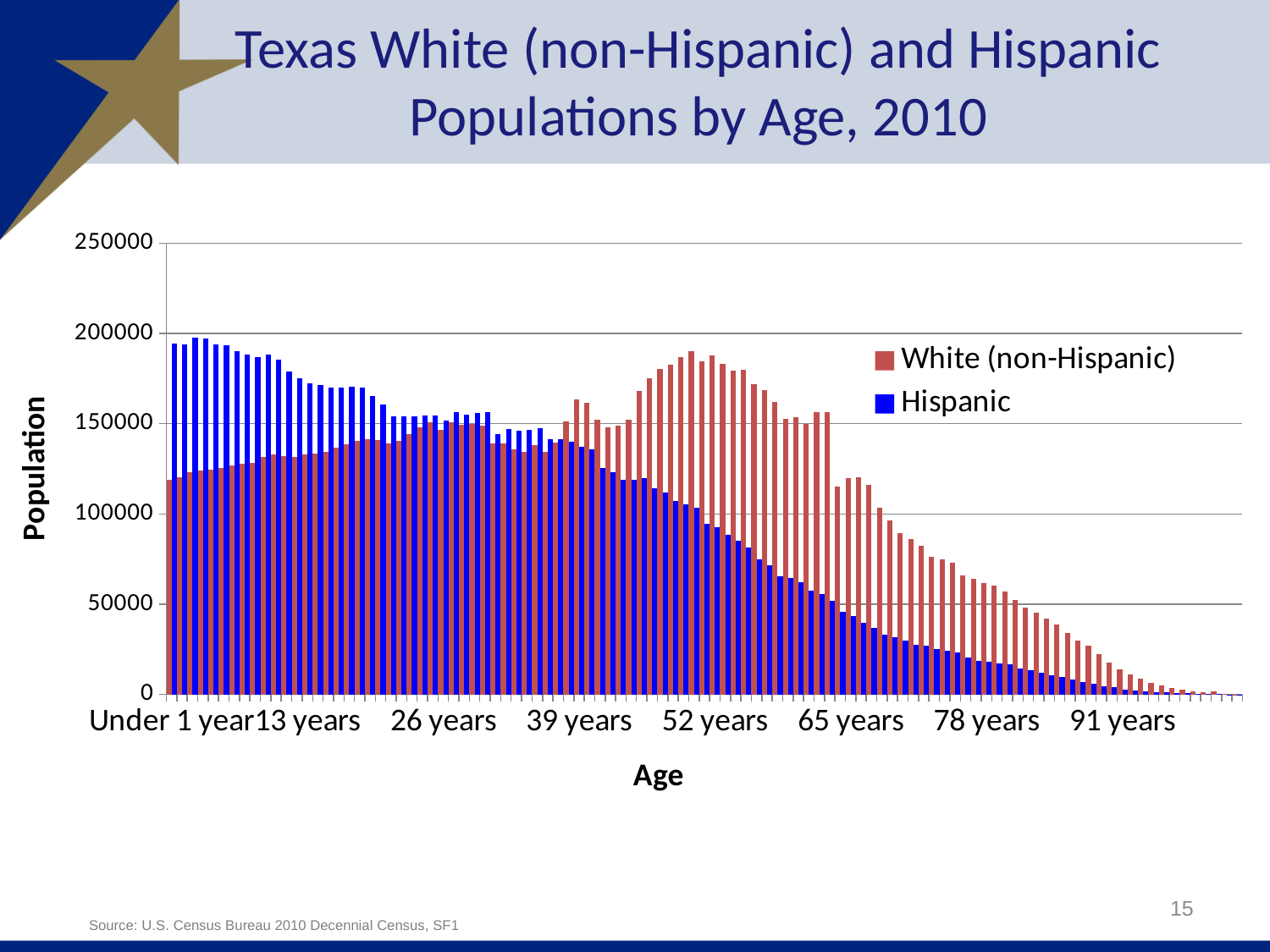
What kind of chart is shown on the slide? bar chart Do the Hispanic values generally rise or fall from 39 years to 91 years? fall Which series has the larger value at 52 years, White (non-Hispanic) or Hispanic? White (non-Hispanic) Is the White (non-Hispanic) value for 52 years greater or less than 150000? greater Is the White (non-Hispanic) value for Under 1 year greater or less than 150000? less What is the label of the vertical axis? Population What are the two series named in the legend? White (non-Hispanic) and Hispanic Is the Hispanic value for Under 1 year greater or less than 150000? greater How many series does the legend list? 2 Which series has the larger value at Under 1 year, White (non-Hispanic) or Hispanic? Hispanic